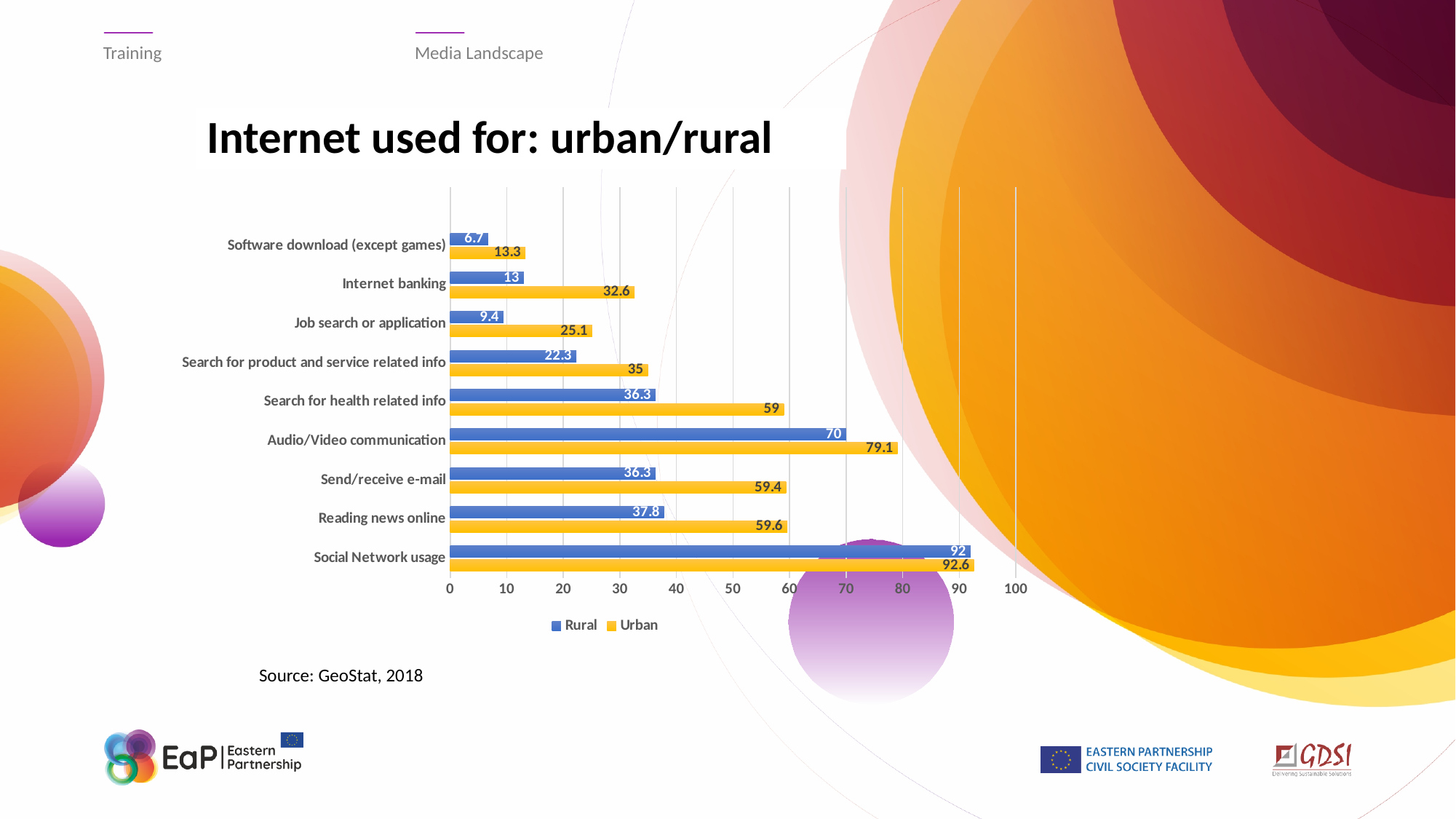
What is the title of the chart? Internet used for: urban/rural What is the Rural value for Audio/Video communication? 70 Which category has the lowest Rural value? Software download (except games) What is the Rural value for Software download (except games)? 6.7 How many series does the legend list? 2 Is the Urban value for Job search or application greater or less than 30? less How many categories are shown on the chart? 9 What kind of chart is shown on the slide? bar chart Which category has the highest Urban value? Social Network usage What is the difference between the Urban and Rural values for Search for health related info? 22.7 Which is larger, the Rural value for Reading news online or the Rural value for Send/receive e-mail? Reading news online What is the Urban value for Internet banking? 32.6